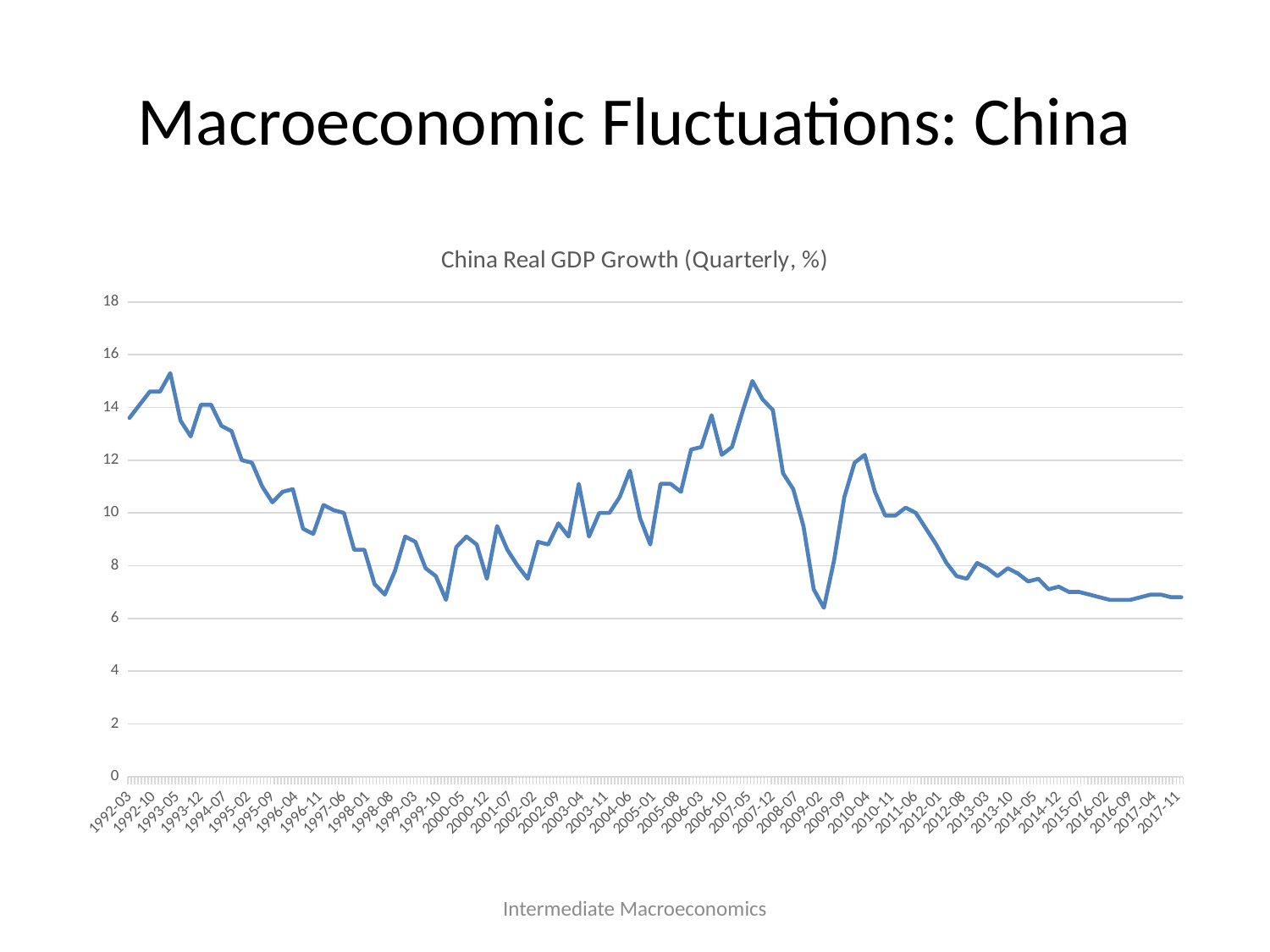
Which is larger, the value for 1992-03 or the value for 2017-11? 1992-03 Which is larger, the value for 2007-05 or the value for 2009-02? 2007-05 Is the value for 1992-03 greater or less than 12? greater Is the value for 1998-08 greater or less than 8? less Is the value for 2009-02 greater or less than 8? less What type of chart is shown on the slide? line chart Do the values generally rise or fall from 2010-04 to 2017-11? fall What is the highest value shown on the vertical axis? 18 What is the title of the chart? China Real GDP Growth (Quarterly, %)